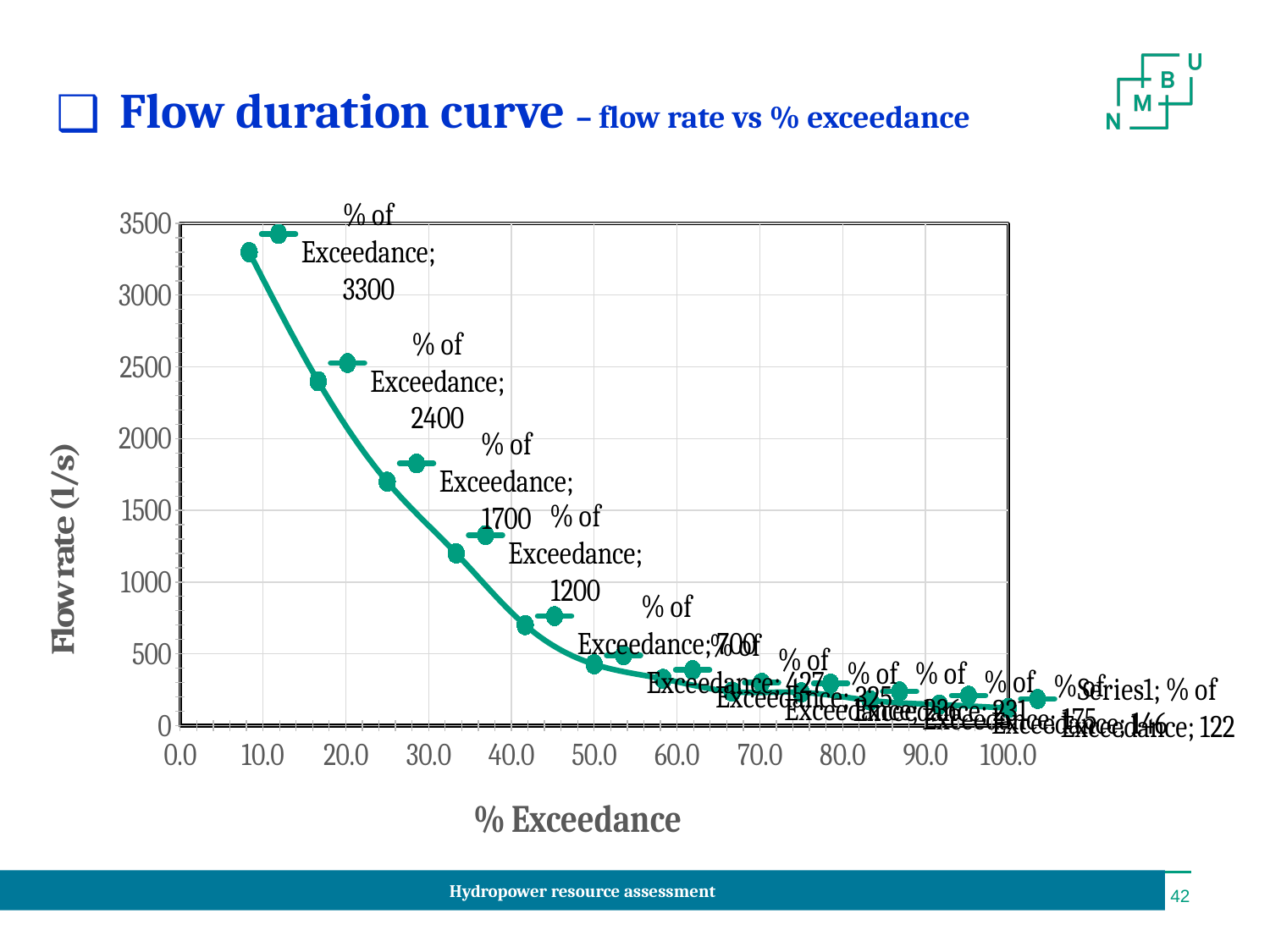
Do the flow rate values rise or fall as % exceedance increases along the x axis? fall What is the title of the y axis? Flow rate (l/s) Is the flow rate at about 50% exceedance greater or less than 500? less What is the highest flow rate value labelled on the curve? 3300 What is the second-highest flow rate value labelled on the curve? 2400 What is the difference between the labelled flow rate values 1700 and 1200? 500 What is the lowest flow rate value labelled on the curve? 122 What is the difference between the labelled flow rate values 3300 and 2400? 900 What is the title of the x axis? % Exceedance Which labelled flow rate value is larger, 700 or 427? 700 Is the flow rate at about 10% exceedance greater or less than 3000? greater What kind of chart is shown on the slide? line chart